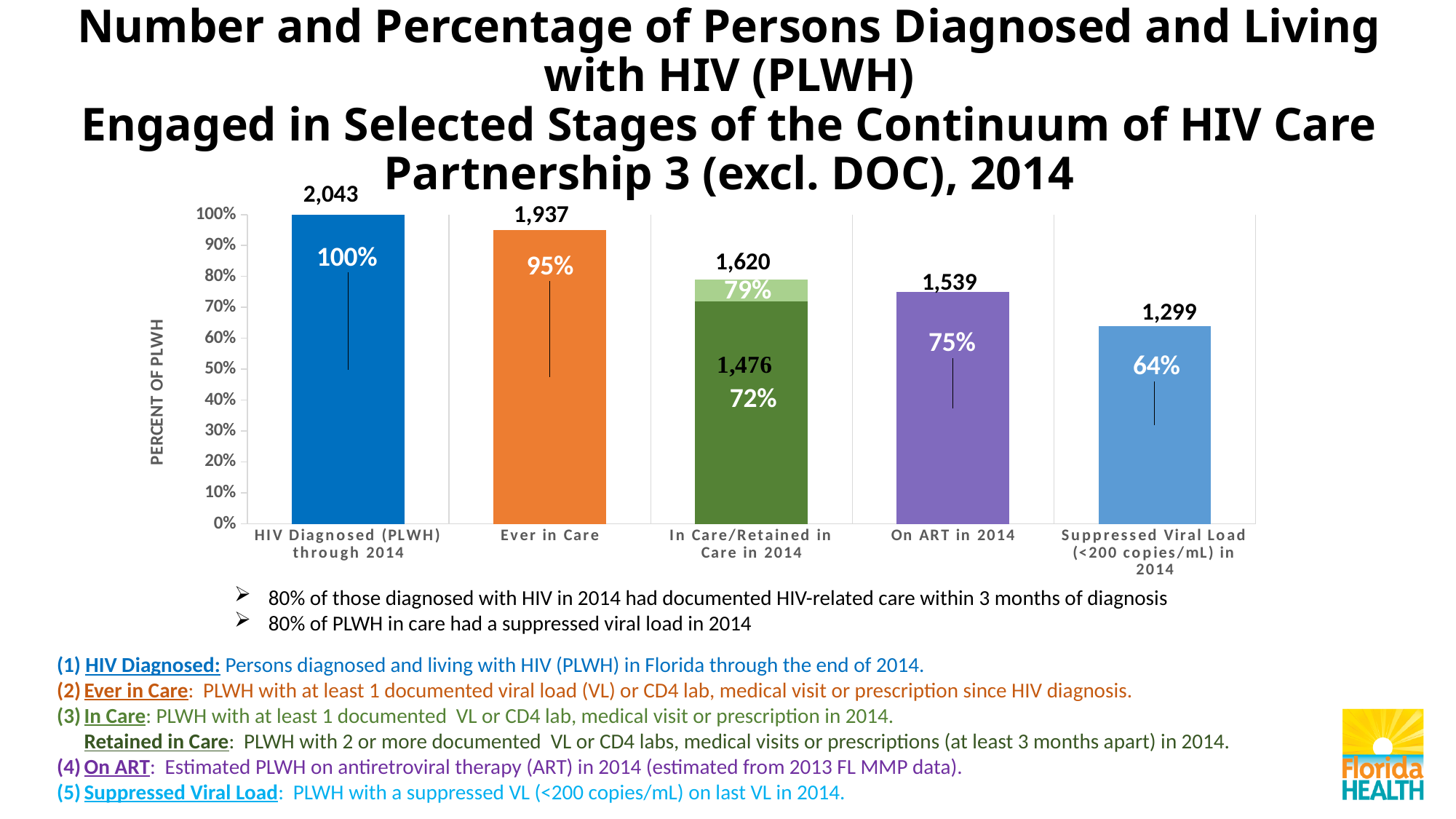
How many categories are shown on the x axis of the chart? 5 What number is labeled at the top of the In Care/Retained in Care in 2014 bar? 1,620 What number is labeled on the bar for HIV Diagnosed (PLWH) through 2014? 2,043 Do the percentages rise or fall moving from left to right across the categories? Fall What percentage is shown for the darker green Retained in Care portion of the In Care/Retained in Care in 2014 bar? 72% Which is larger, the percentage for On ART in 2014 or the percentage for Suppressed Viral Load (<200 copies/mL) in 2014? On ART in 2014 What percentage is shown for Ever in Care? 95% Which category has the highest number of persons? HIV Diagnosed (PLWH) through 2014 Which category has the lowest percentage of PLWH? Suppressed Viral Load (<200 copies/mL) in 2014 What is the difference in number of persons between Ever in Care and On ART in 2014? 398 What number is labeled on the bar for Suppressed Viral Load (<200 copies/mL) in 2014? 1,299 What kind of chart is shown on the slide? Bar chart